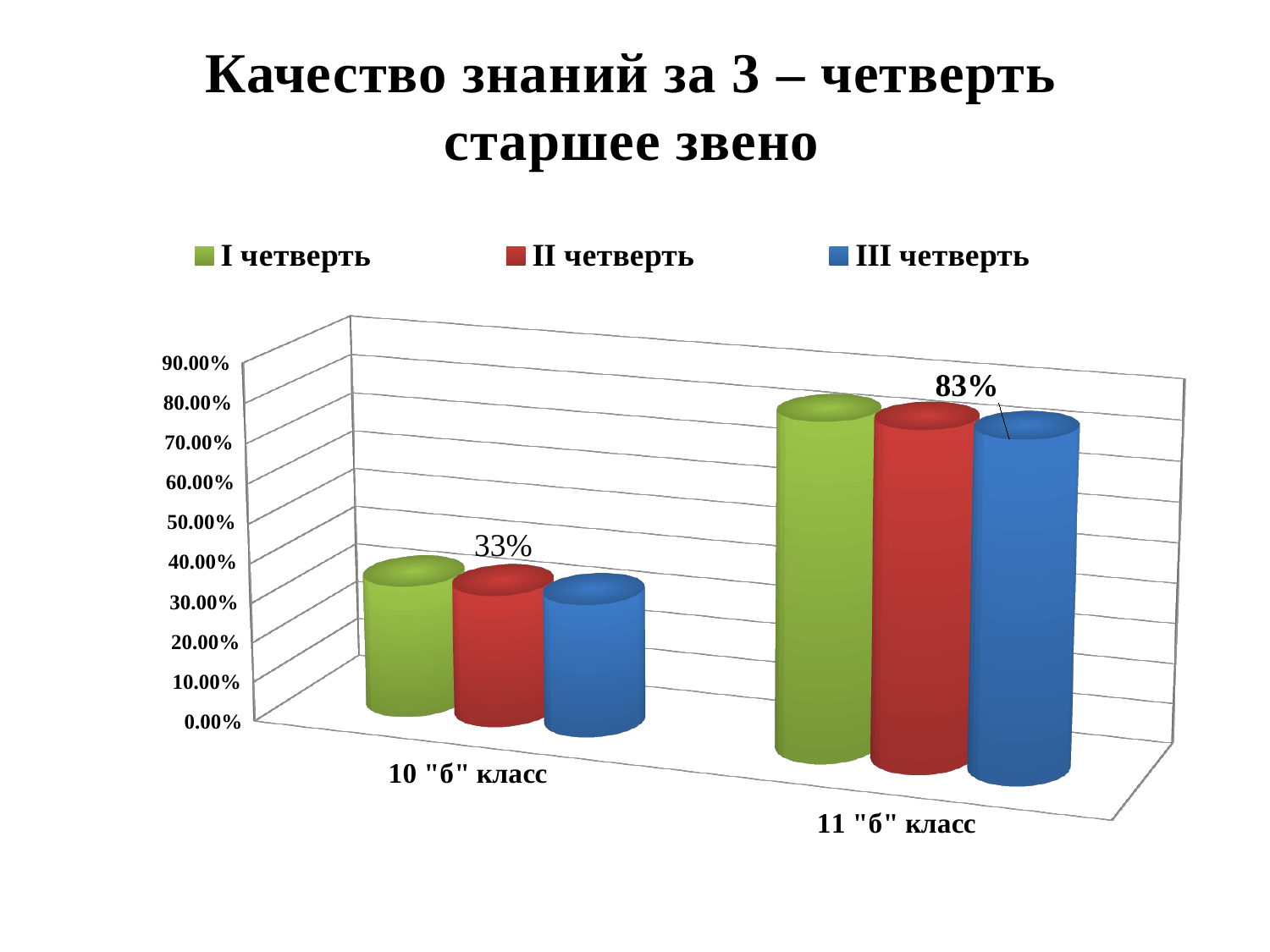
What is the difference between the labelled values for 11 "б" класс (83%) and 10 "б" класс (33%)? 50% What is the data label shown for 10 "б" класс? 33% What is the data label shown for 11 "б" класс? 83% Is the value for I четверть in 10 "б" класс greater or less than 50.00%? less What colour represents III четверть in the legend? blue Which class has the lowest values? 10 "б" класс Which is larger: the II четверть value for 10 "б" класс or for 11 "б" класс? 11 "б" класс Which class has the higher values across all quarters? 11 "б" класс Is the value for I четверть in 11 "б" класс greater or less than 50.00%? greater How many classes (categories) are shown on the x axis? 2 How many series does the legend list? 3 What kind of chart is shown on the slide? bar chart